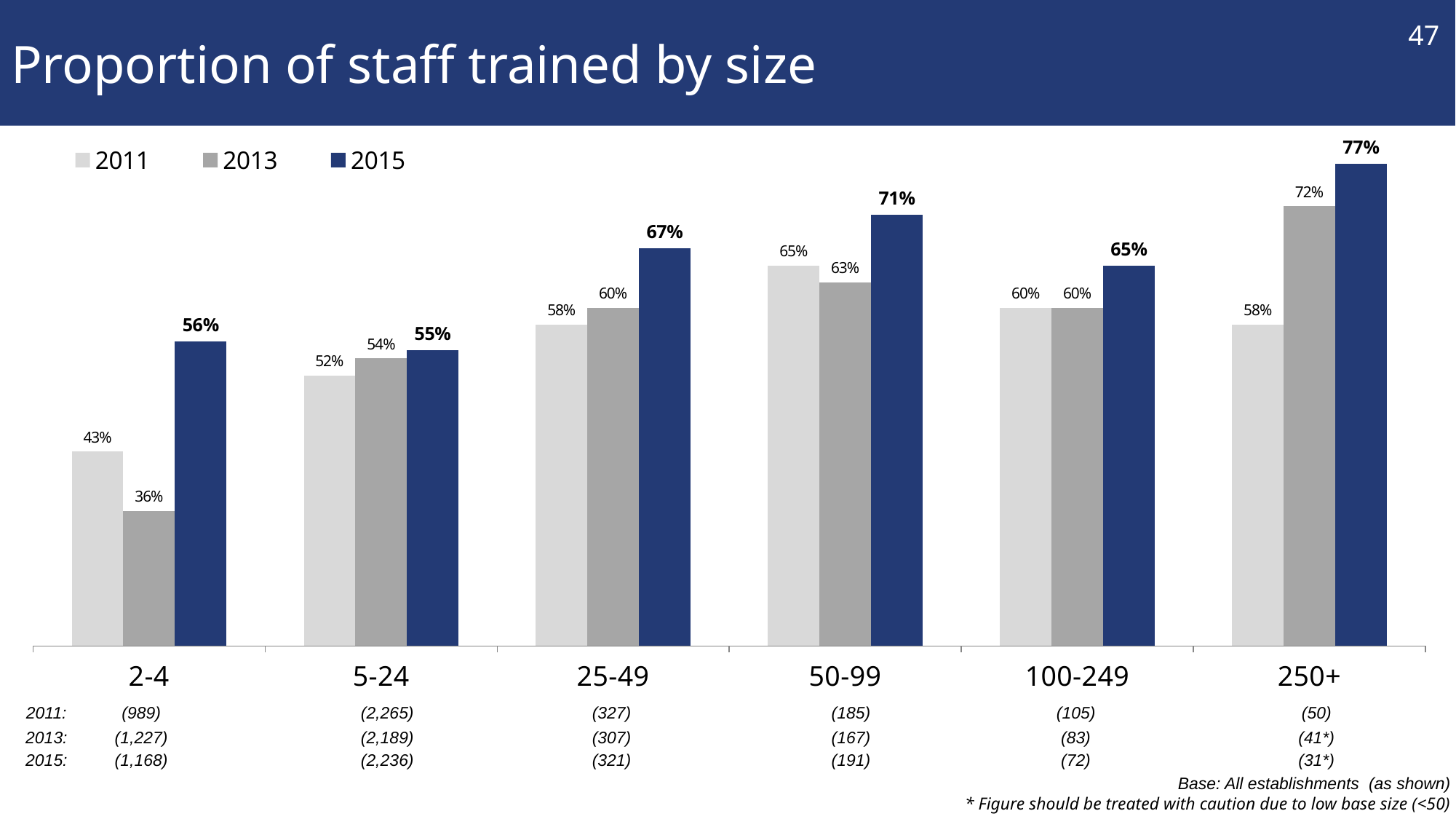
What kind of chart is shown on the slide? Bar chart Which size band has the lowest proportion of staff trained in 2013? 2-4 How many size bands are shown on the x axis? 6 What is the proportion of staff trained in 2011 for establishments with 50-99 staff? 65% What is the difference between the 2015 and 2011 values for the 2-4 size band? 13 percentage points Do the 2015 values generally rise or fall as establishment size increases from 2-4 to 250+? Rise What is the proportion of staff trained in 2015 for establishments with 250+ staff? 77% Which size band has the highest proportion of staff trained in 2015? 250+ How many series does the legend list? 3 Which colour represents the 2015 series in the chart? Dark blue Which is larger for the 50-99 size band: the 2011 value or the 2013 value? 2011 What is the proportion of staff trained in 2013 for establishments with 2-4 staff? 36%